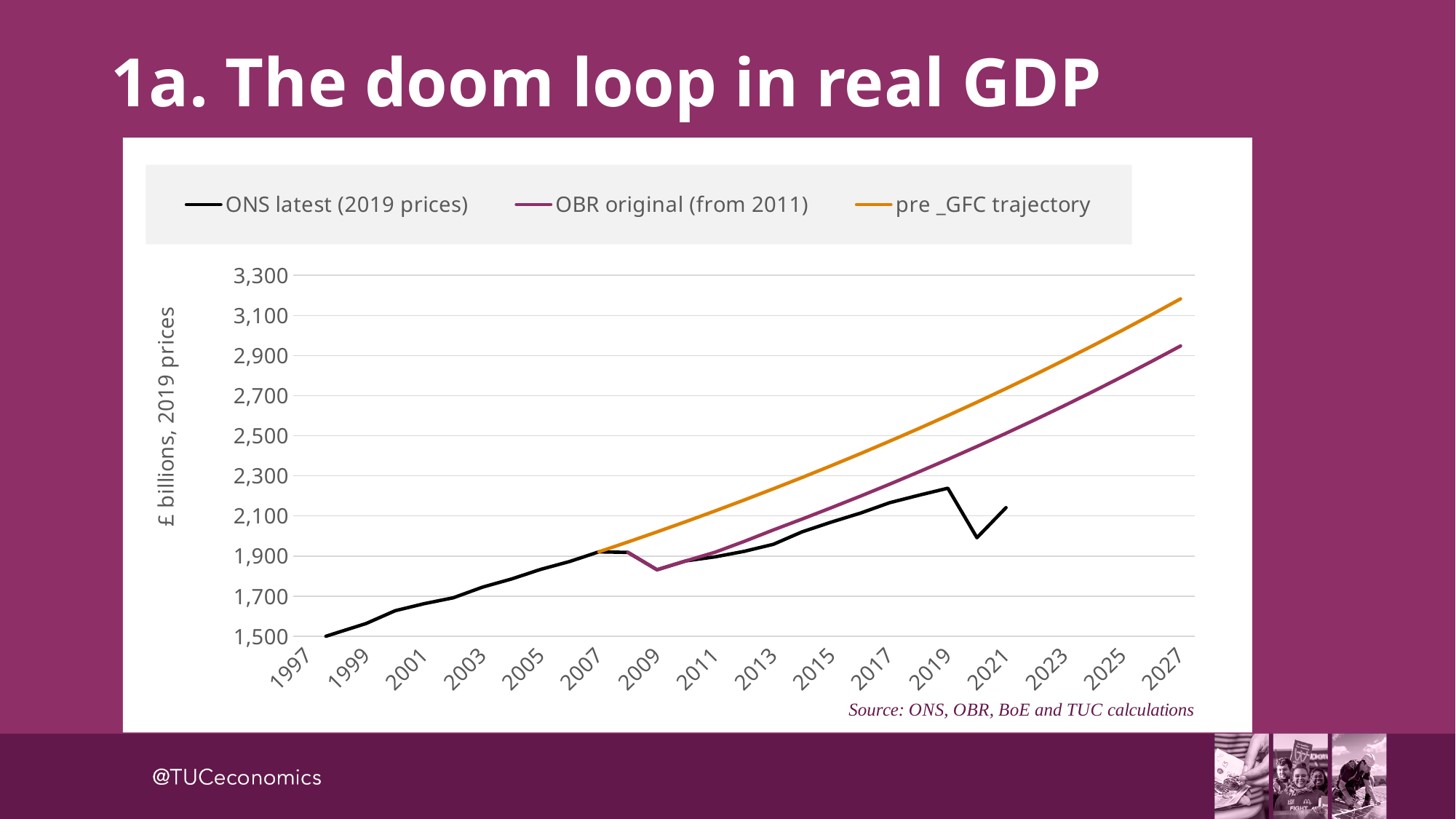
Is the value of ONS latest (2019 prices) in 2019 greater or less than 2,100? greater Is the value of ONS latest (2019 prices) in 2020 greater or less than 2,100? less Does the pre _GFC trajectory series rise or fall from 2007 to 2027? Rise What type of chart is shown on the slide? Line chart Is the value of OBR original (from 2011) in 2027 greater or less than 3,100? less What is the label on the vertical axis of the chart? £ billions, 2019 prices In 2027, which series has the higher value: pre _GFC trajectory or OBR original (from 2011)? pre _GFC trajectory How many series does the legend list? 3 In 2019, which series has the higher value: OBR original (from 2011) or ONS latest (2019 prices)? OBR original (from 2011) Which series is drawn in orange according to the legend? pre _GFC trajectory